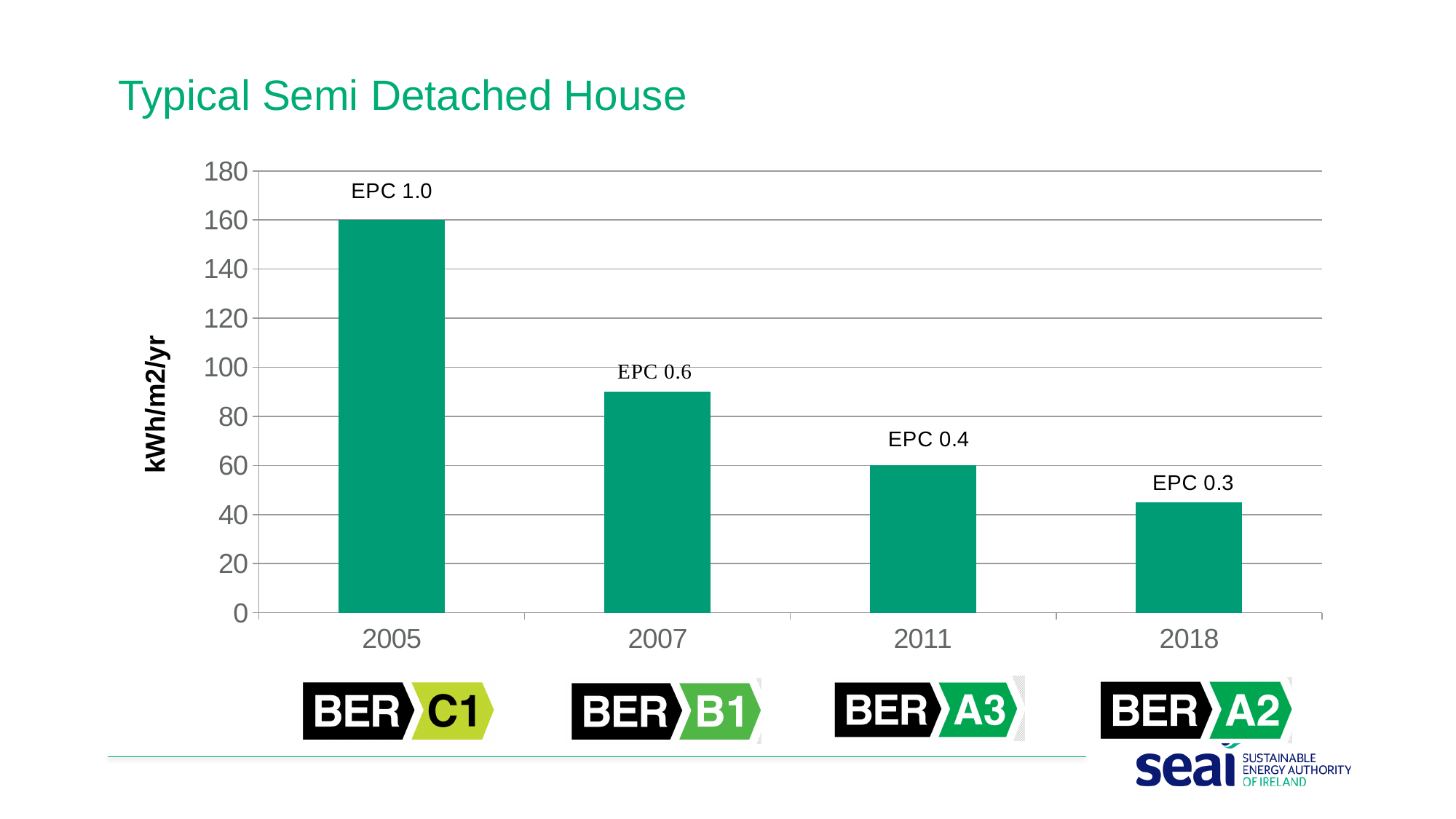
What is the label on the vertical axis of the chart? kWh/m2/yr What is the value in kWh/m2/yr for 2005? 160 What is the value in kWh/m2/yr for 2011? 60 What kind of chart is shown on the slide? bar chart Do the values rise or fall from 2005 to 2018? fall Which year has the highest value on the chart? 2005 How many years (bars) are plotted on the chart? 4 What is the difference between the values for 2005 and 2011? 100 Which year has the larger value, 2007 or 2011? 2007 Is the value for 2007 greater or less than 100? less Which year has the lowest value on the chart? 2018 Is the value for 2018 greater or less than 60? less